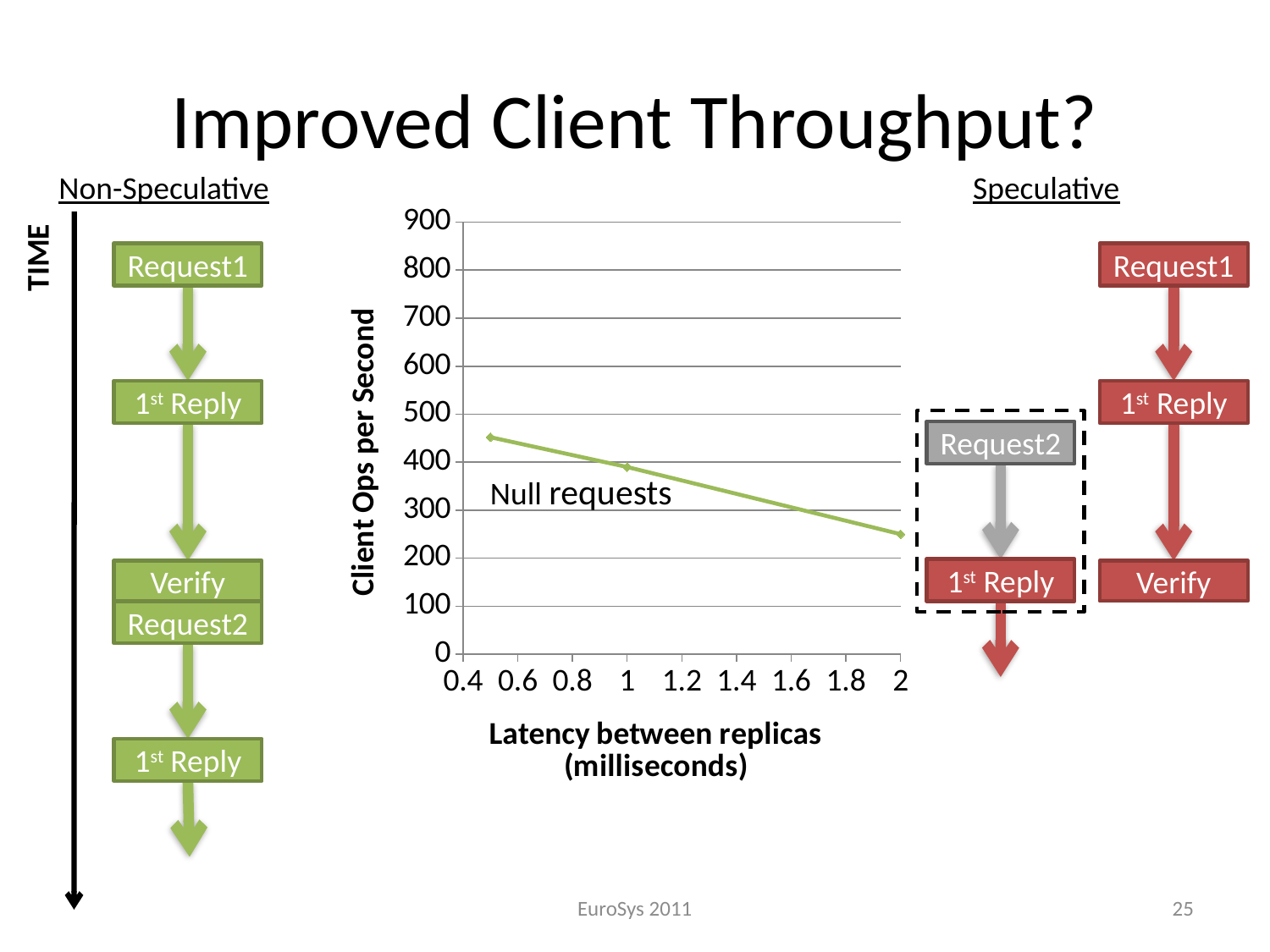
Do the values rise or fall as latency between replicas increases along the x axis? fall Is the value at the leftmost data point greater or less than 500? less Is the value at a latency of 2 milliseconds greater or less than 200? greater Is the value at the leftmost data point greater or less than 400? greater Which is larger: the value at a latency of 1 millisecond or at 2 milliseconds? 1 millisecond What label is given to the plotted line? Null requests What kind of chart is shown on the slide? line chart How many data points are plotted on the line? 3 At which latency is the plotted value lowest? 2 What is the label of the y axis? Client Ops per Second